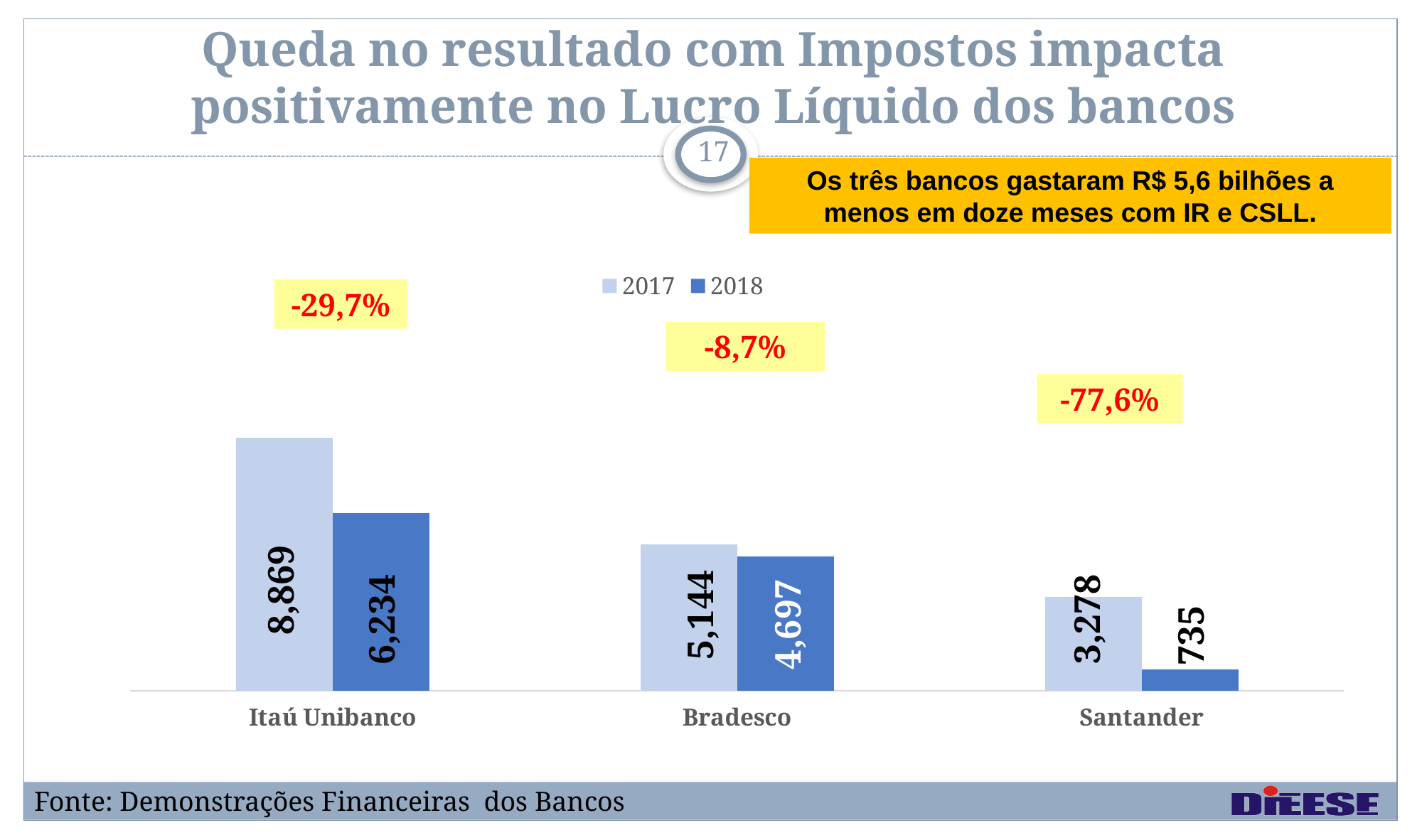
What is the 2018 value for Santander? 735 How many banks are shown on the x axis of the chart? 3 How many series does the chart legend list? 2 Which bank has the highest 2017 value? Itaú Unibanco What kind of chart is shown on the slide? Bar chart What is the 2017 value for Itaú Unibanco? 8,869 What is the difference between the 2017 and 2018 values for Itaú Unibanco? 2,635 What percentage change is shown above the Santander bars? -77,6% Which is larger: the 2018 value for Bradesco or the 2017 value for Santander? 2018 value for Bradesco Which bank has the lowest 2018 value? Santander What is the 2018 value for Bradesco? 4,697 What is the difference between the 2017 and 2018 values for Bradesco? 447